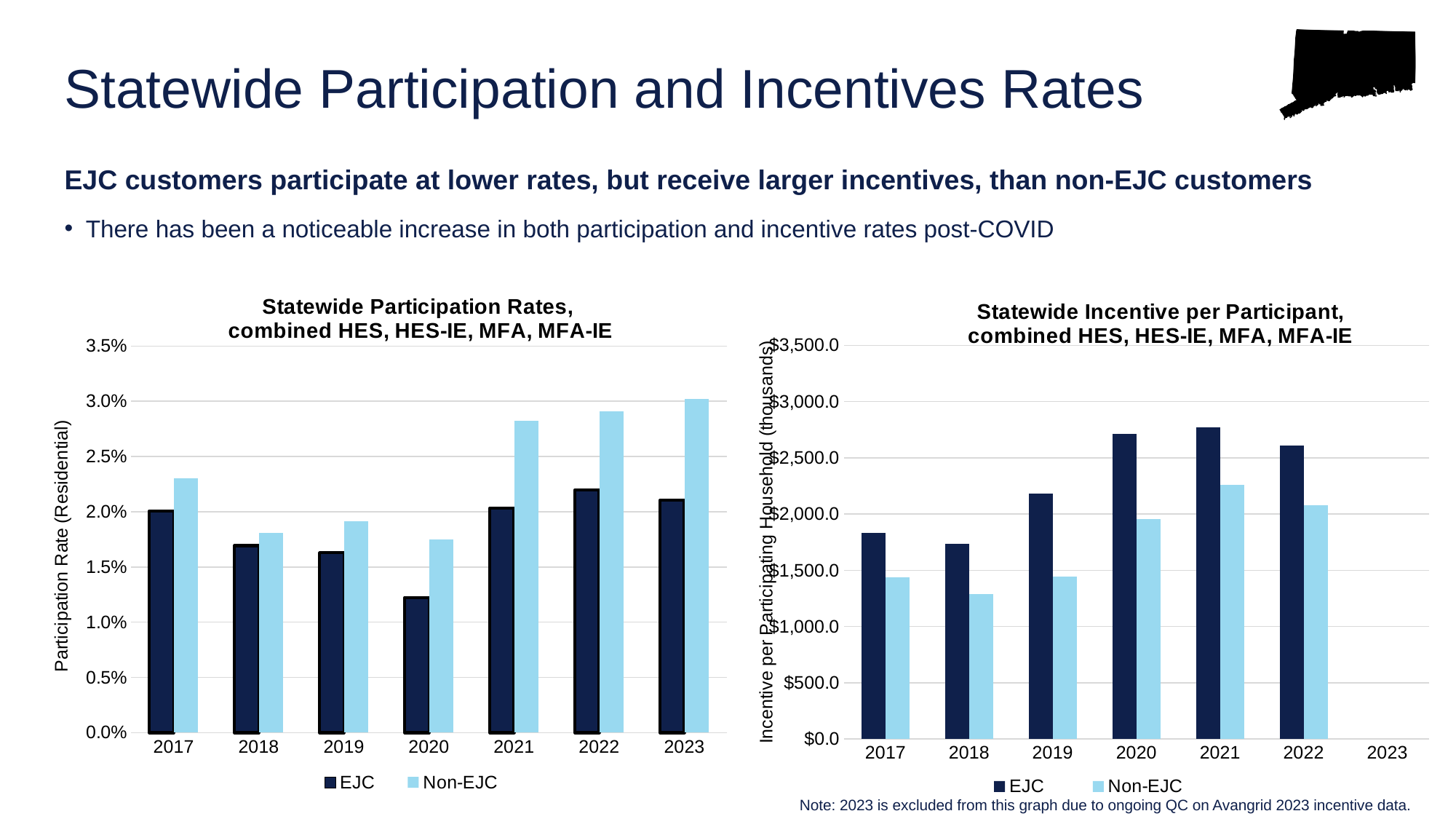
In the 'Statewide Participation Rates' chart, which year has the lowest EJC participation rate? 2020 In the 'Statewide Incentive per Participant' chart, is the EJC value for 2020 greater or less than $2,500.0? greater What kind of chart is the 'Statewide Participation Rates' chart on the left? bar chart How many series does the legend of the 'Statewide Participation Rates' chart list? 2 In the 'Statewide Incentive per Participant' chart, which series has the larger value in 2022, EJC or Non-EJC? EJC According to the note under the 'Statewide Incentive per Participant' chart, which year is excluded from that graph? 2023 In the 'Statewide Participation Rates' chart, is the Non-EJC value for 2021 greater or less than 2.5%? greater In the 'Statewide Participation Rates' chart, which year has the highest Non-EJC participation rate? 2023 In the 'Statewide Participation Rates' chart, which series has the larger value in 2017, EJC or Non-EJC? Non-EJC In the 'Statewide Participation Rates' chart, is the EJC value for 2020 greater or less than 1.5%? less In the 'Statewide Incentive per Participant' chart, which year has the lowest Non-EJC incentive? 2018